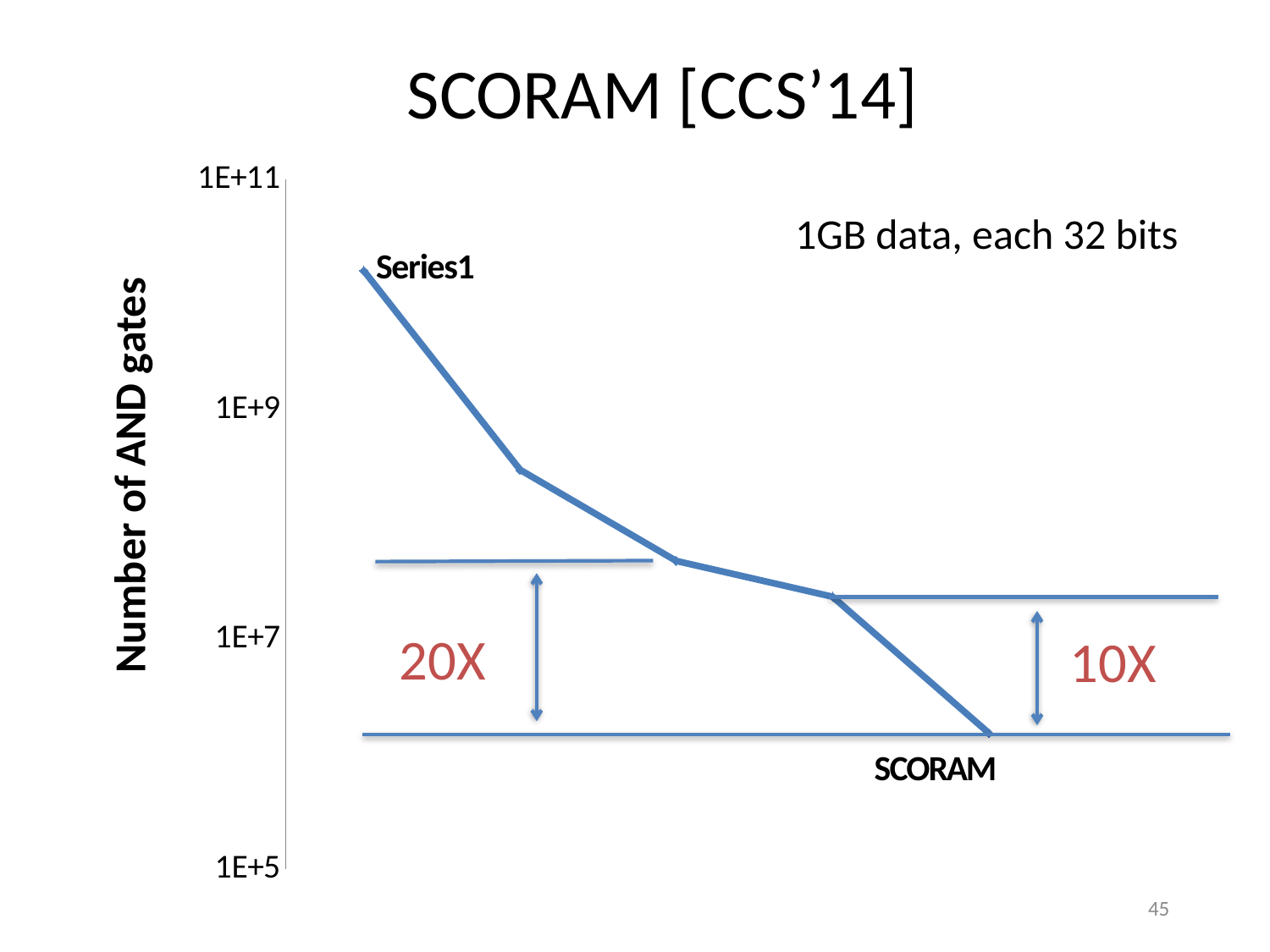
What kind of chart is shown on the slide? line chart What is the label on the vertical axis of the chart? Number of AND gates What is the lowest tick value shown on the vertical axis? 1E+5 Is the value for the first point (labelled Series1) greater or less than 1E+9? greater Is the value for the SCORAM point greater or less than 1E+7? less Which labelled point on the line has the highest number of AND gates? Series1 Which labelled point on the line has the lowest number of AND gates? SCORAM What is the title of the slide's chart? SCORAM [CCS'14] Do the values of the line rise or fall from left to right along the x axis? fall How many data points are plotted on the line? 5 What is the highest tick value shown on the vertical axis? 1E+11 Which of the two annotated improvement factors on the chart is larger, 20X or 10X? 20X